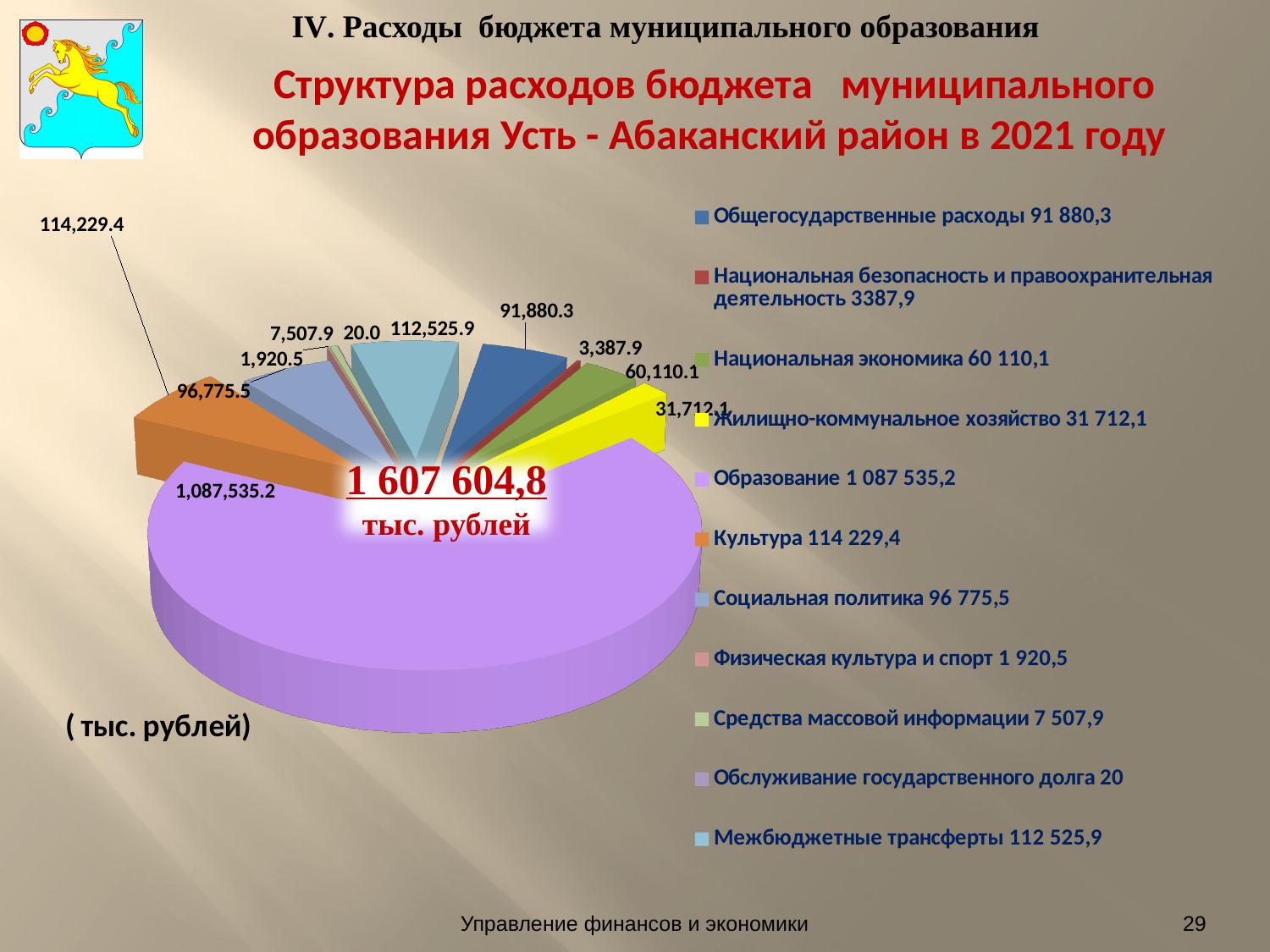
Which category has the largest slice of the pie chart? Образование What share of the total 1 607 604,8 does Образование (1,087,535.2) represent? 67.6% What is the difference between the values for Культура and Межбюджетные трансферты? 1,703.5 What is the value shown for Культура on the pie chart? 114,229.4 What kind of chart is shown on the slide? Pie chart What value does the legend give for Жилищно-коммунальное хозяйство? 31 712,1 How many categories does the legend of the pie chart list? 11 What is the difference between the values for Общегосударственные расходы and Национальная экономика? 31,770.2 Which category has the smallest value on the pie chart? Обслуживание государственного долга What is the value shown for Образование on the pie chart? 1,087,535.2 Which is larger, Социальная политика or Общегосударственные расходы? Социальная политика What total is printed in the centre of the pie chart? 1 607 604,8 тыс. рублей